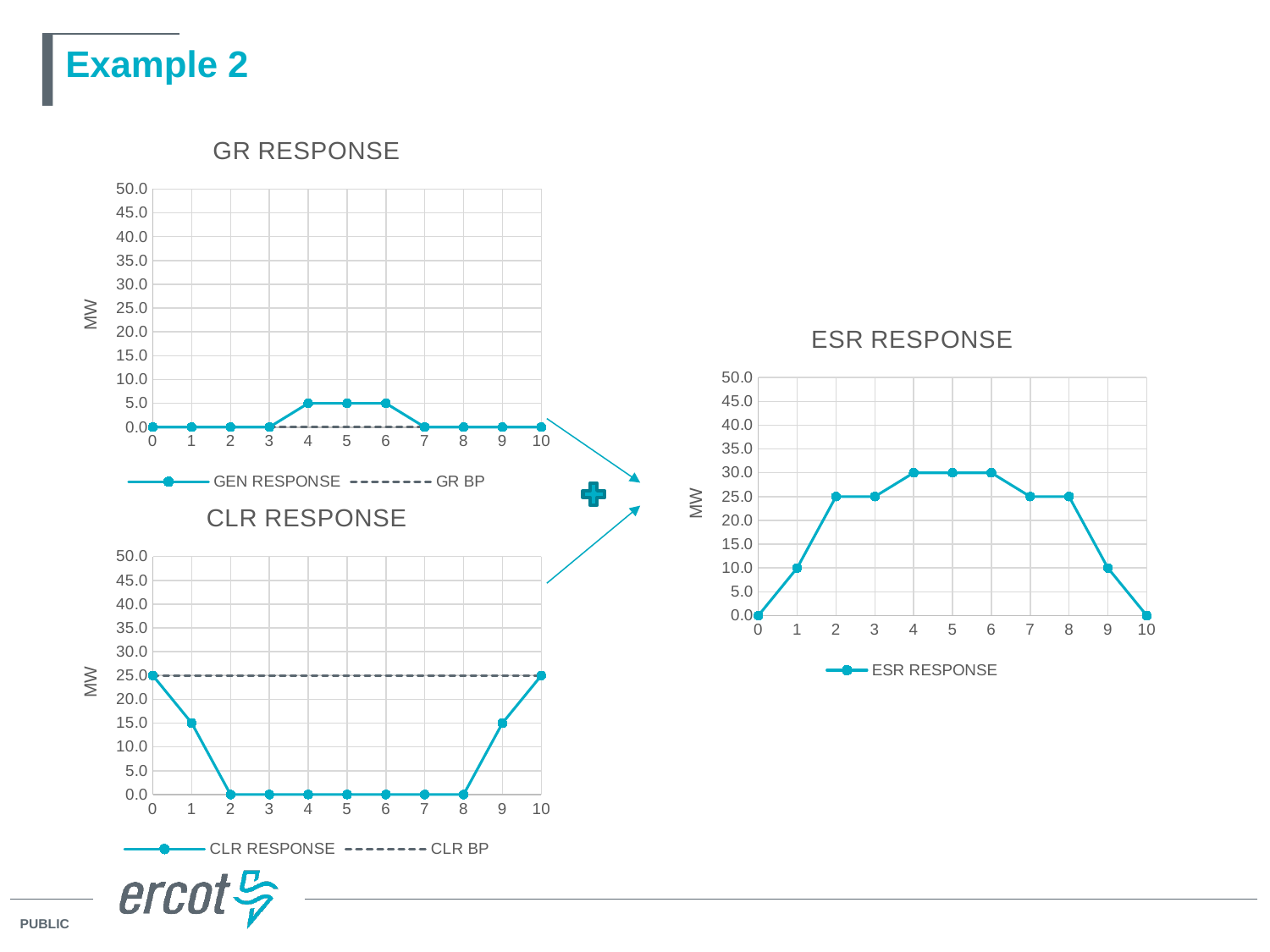
In the CLR RESPONSE chart, what is the CLR RESPONSE value at x = 0? 25.0 In the ESR RESPONSE chart, what is the ESR RESPONSE value at x = 1? 10.0 In the ESR RESPONSE chart, what is the ESR RESPONSE value at x = 4? 30.0 In the GR RESPONSE chart, what is the GEN RESPONSE value at x = 5? 5.0 In the CLR RESPONSE chart, does the CLR RESPONSE line rise or fall between x = 0 and x = 2? fall In the ESR RESPONSE chart, which is larger: the ESR RESPONSE value at x = 6 or at x = 9? x = 6 In the ESR RESPONSE chart, is the ESR RESPONSE value at x = 4 greater or less than 20.0? greater In the GR RESPONSE chart, how many series does the legend list? 2 What kind of chart is the ESR RESPONSE chart? line chart In the ESR RESPONSE chart, what is the difference between the ESR RESPONSE values at x = 5 and x = 2? 5.0 In the CLR RESPONSE chart, at what MW level is the dashed CLR BP line drawn? 25.0 In the CLR RESPONSE chart, what is the CLR RESPONSE value at x = 1? 15.0